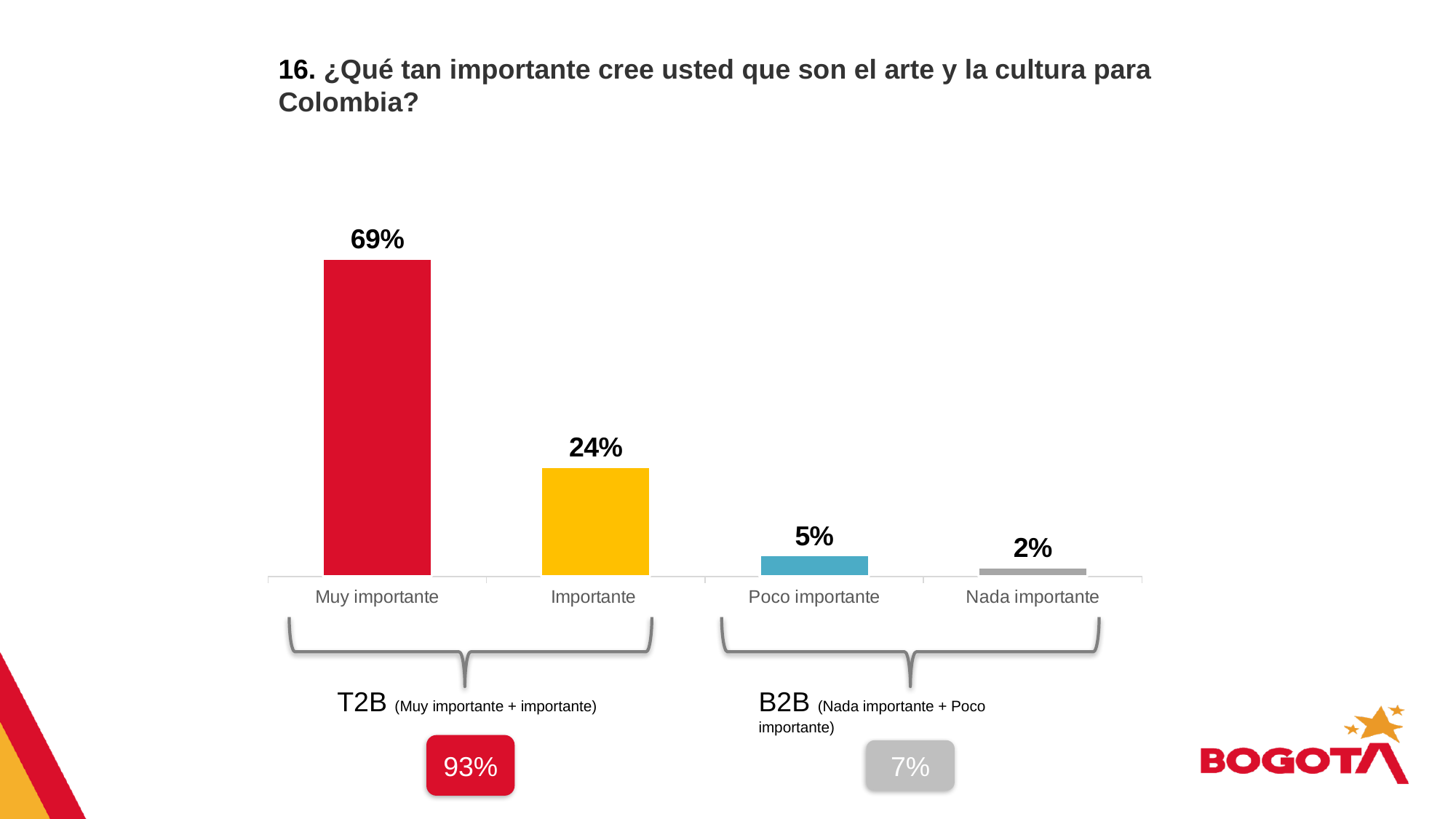
Do the values rise or fall from left to right across the categories? Fall What T2B (Muy importante + importante) percentage is shown below the chart? 93% What kind of chart is shown on the slide? Bar chart What percentage of respondents answered "Muy importante"? 69% What is the value shown for "Nada importante"? 2% How many categories are shown in the chart? 4 What is the difference between the values for "Muy importante" and "Importante"? 45% What is the value shown for "Importante"? 24% What is the value shown for "Poco importante"? 5% Which category has the lowest value? Nada importante Which is larger, the value for "Poco importante" or the value for "Nada importante"? Poco importante Which category has the highest value? Muy importante